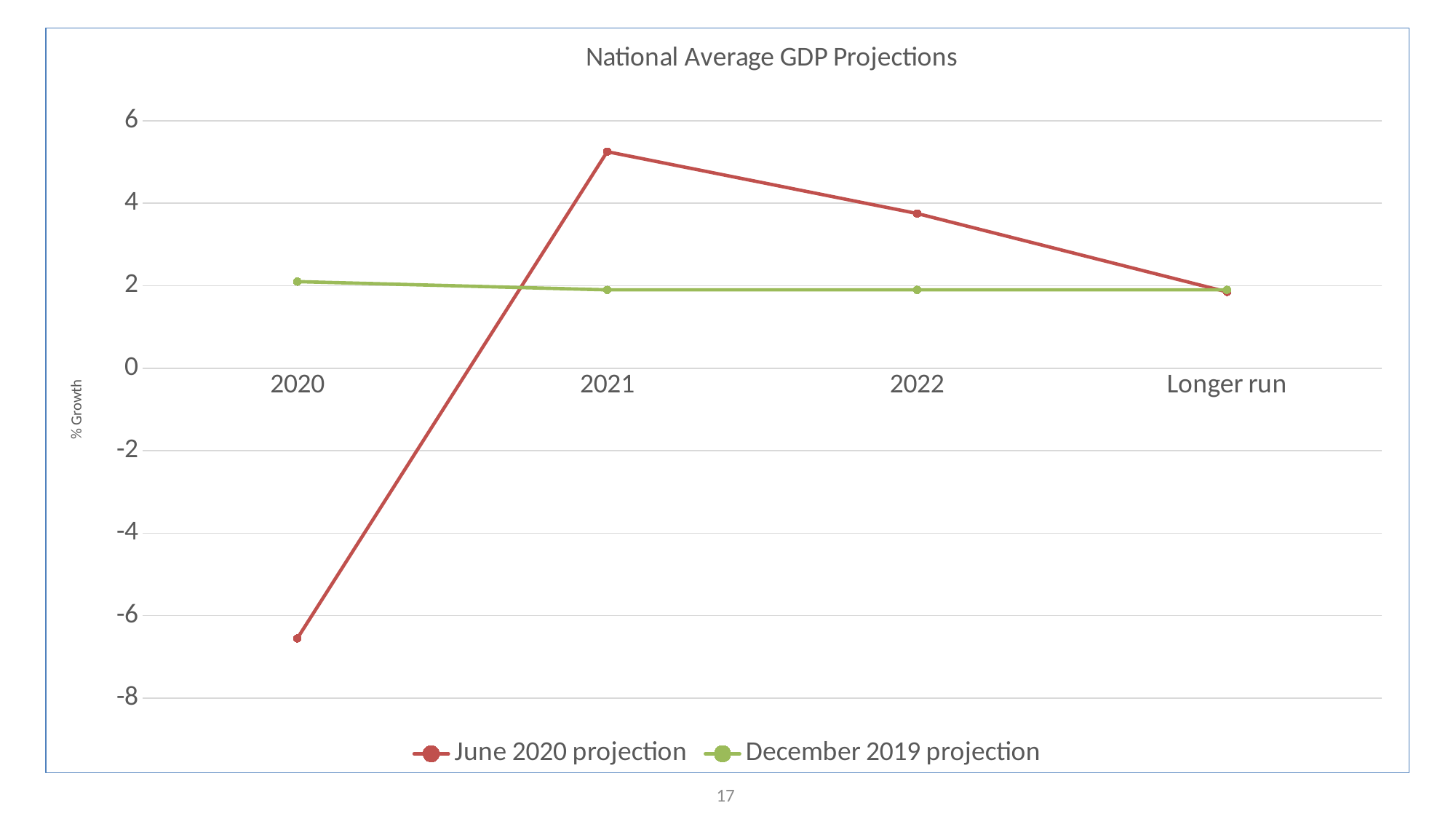
For the June 2020 projection, which category has the lowest value? 2020 Is the June 2020 projection value for 2022 greater or less than 2? greater In 2021, which series has the larger value, June 2020 projection or December 2019 projection? June 2020 projection In 2020, which series has the larger value, June 2020 projection or December 2019 projection? December 2019 projection How many categories are shown on the x axis? 4 For the June 2020 projection, which category has the highest value? 2021 How many series does the legend list? 2 What kind of chart is shown on the slide? line chart Is the June 2020 projection value for 2020 greater or less than -6? less Does the June 2020 projection rise or fall from 2021 to Longer run? fall Is the June 2020 projection value for 2021 greater or less than 4? greater What is the title of the chart? National Average GDP Projections